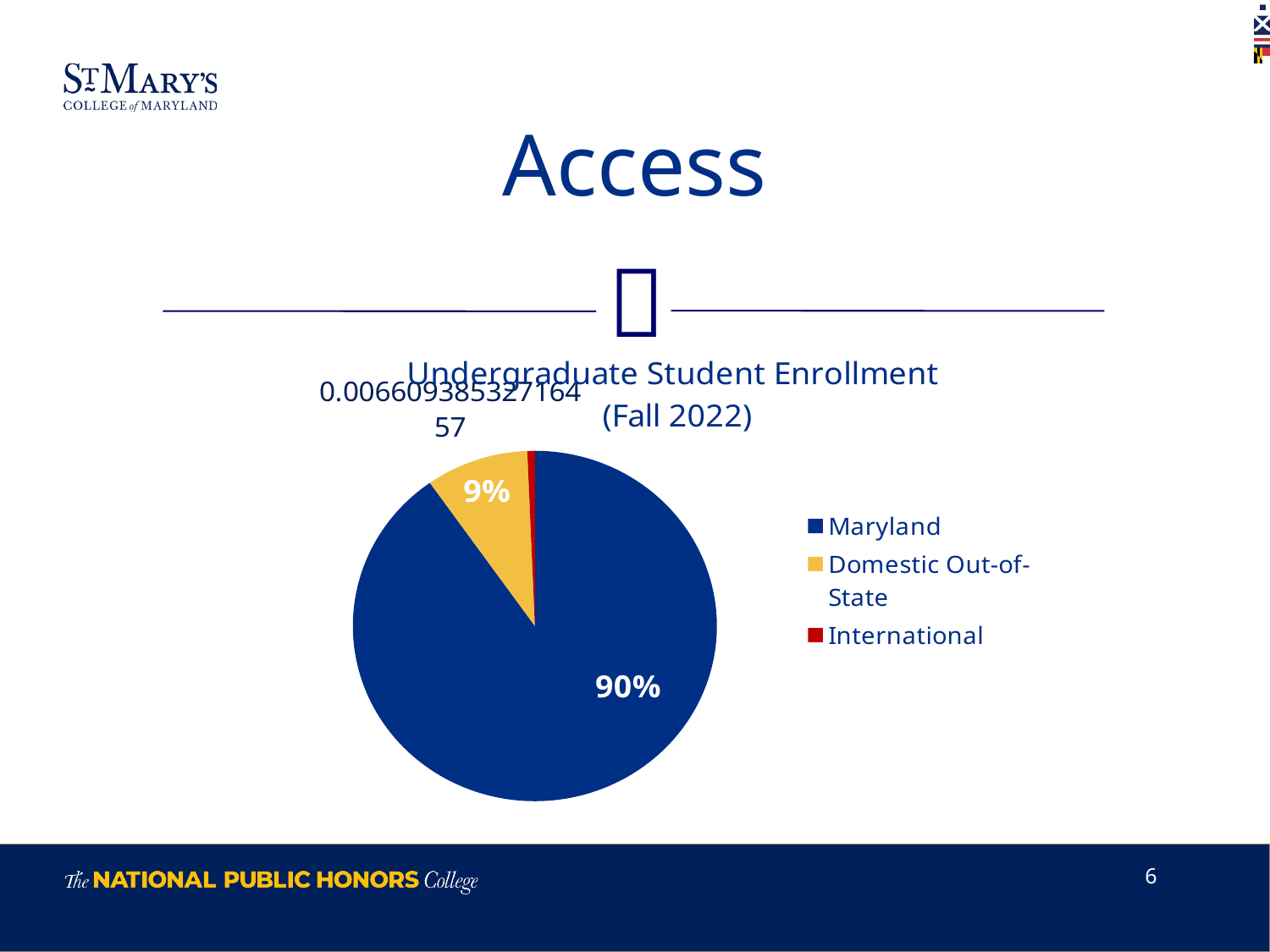
How many entries does the legend list? 3 Which category has the largest share of undergraduate student enrollment? Maryland Which category has the smallest slice of the pie chart? International What percentage of undergraduate student enrollment is Domestic Out-of-State? 9% What colour is the Domestic Out-of-State slice in the pie chart? Yellow What kind of chart is shown on the slide? Pie chart How many categories are shown in the pie chart? 3 What share of the pie does the Maryland slice represent? 90% By how many percentage points does the Maryland share exceed the Domestic Out-of-State share? 81 percentage points What is the title of the chart? Undergraduate Student Enrollment (Fall 2022) What percentage of undergraduate student enrollment is from Maryland? 90% Which is larger, the Maryland share or the Domestic Out-of-State share? Maryland